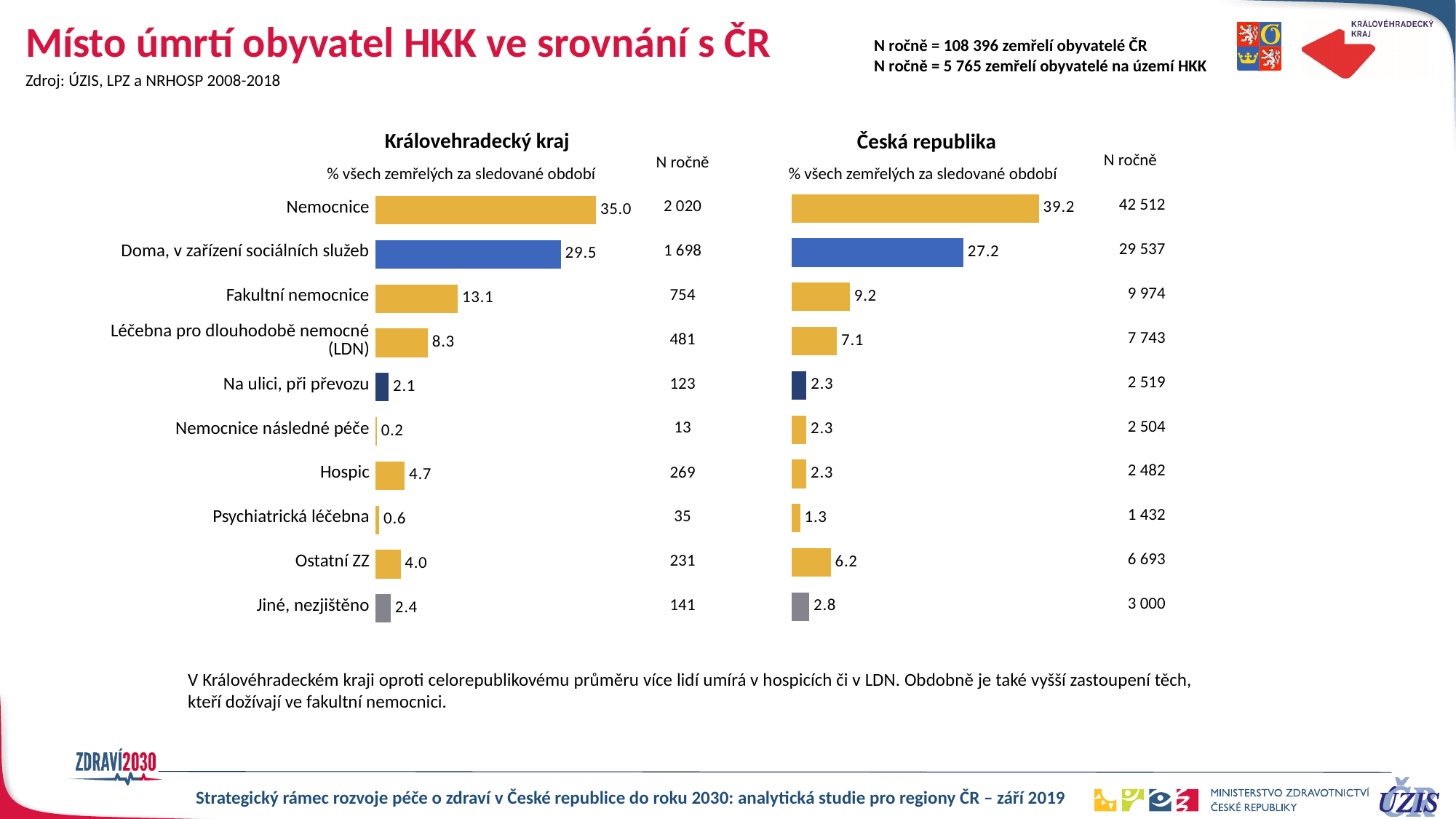
In the Královehradecký kraj chart, what is the difference between the Fakultní nemocnice and Léčebna pro dlouhodobě nemocné (LDN) percentages? 4.8 What type of chart is used for the Královehradecký kraj data? Bar chart In the Královehradecký kraj chart, what is the N ročně value for Hospic? 269 In the Královehradecký kraj chart, which category has the highest percentage? Nemocnice In the Královehradecký kraj chart, which category has the lowest percentage? Nemocnice následné péče How many categories are shown in the Česká republika chart? 10 In the Královehradecký kraj chart, what percentage of deaths occurred in Nemocnice? 35.0 In the Česká republika chart, what percentage of deaths occurred in Doma, v zařízení sociálních služeb? 27.2 What is the difference between the Nemocnice percentage in the Česká republika chart and in the Královehradecký kraj chart? 4.2 Is the Hospic percentage larger in the Královehradecký kraj chart or in the Česká republika chart? Královehradecký kraj In the Česká republika chart, which category has the lowest percentage? Psychiatrická léčebna In the Česká republika chart, what is the N ročně value for Ostatní ZZ? 6 693